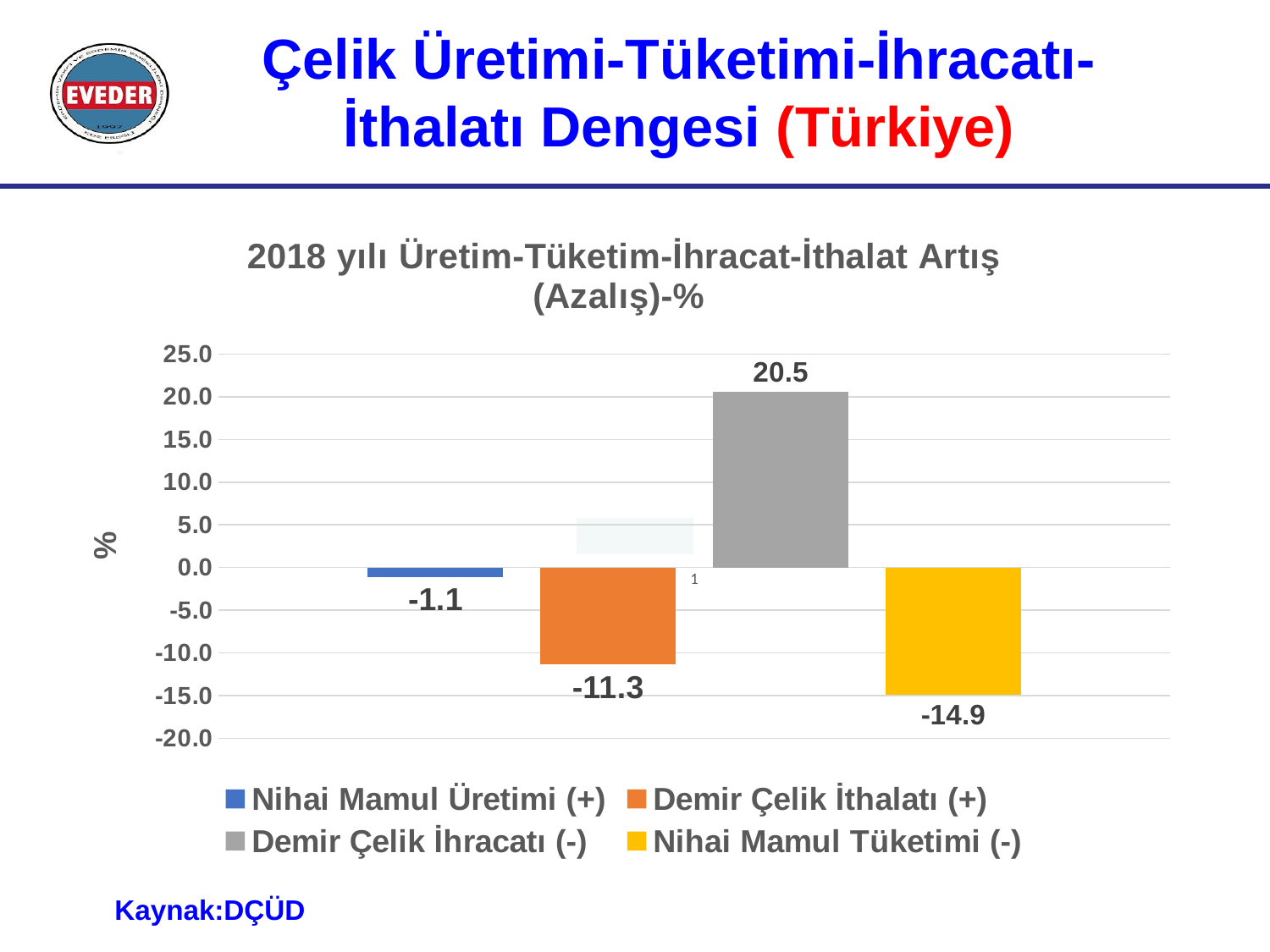
What is the value for Demir Çelik İhracatı (-)? 20.5 What is the difference between the values for Demir Çelik İhracatı (-) and Nihai Mamul Tüketimi (-)? 35.4 What kind of chart is shown on the slide? bar chart What is the title of the chart? 2018 yılı Üretim-Tüketim-İhracat-İthalat Artış (Azalış)-% What is the value for Nihai Mamul Üretimi (+)? -1.1 How many series does the legend list? 4 Is the value for Demir Çelik İhracatı (-) greater or less than 20.0? greater What is the value for Demir Çelik İthalatı (+)? -11.3 What is the value for Nihai Mamul Tüketimi (-)? -14.9 Which series has the lowest value? Nihai Mamul Tüketimi (-) Which is larger, the value for Nihai Mamul Üretimi (+) or the value for Demir Çelik İthalatı (+)? Nihai Mamul Üretimi (+) Which series has the highest value? Demir Çelik İhracatı (-)